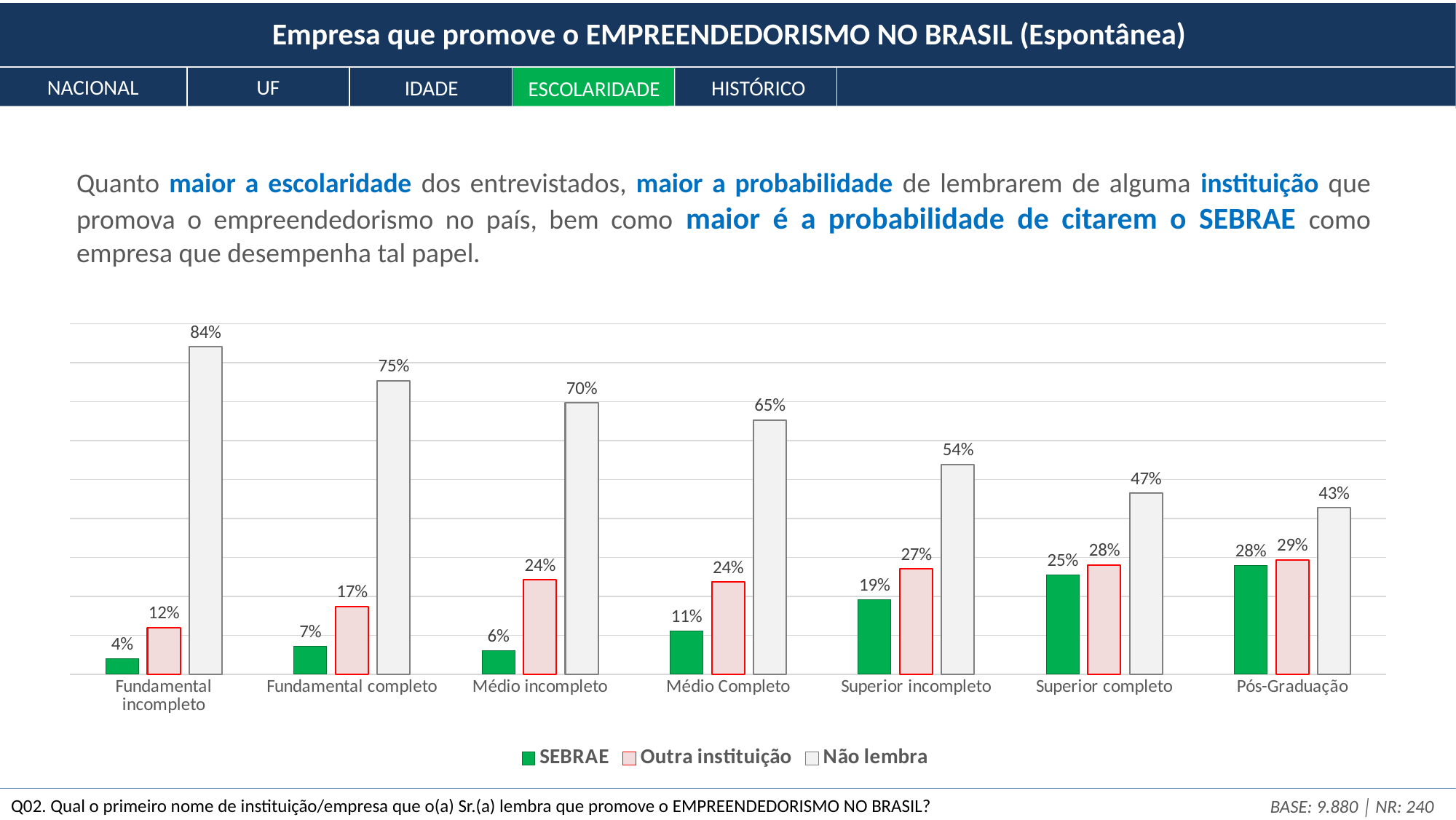
Which education level has the lowest SEBRAE value? Fundamental incompleto What kind of chart is shown on the slide? Bar chart How many education levels are shown on the x axis? 7 Which education level has the highest Não lembra value? Fundamental incompleto Which is larger for Superior incompleto: the SEBRAE value or the Outra instituição value? Outra instituição How many series does the legend list? 3 Which series is shown in green? SEBRAE What is the Outra instituição value for Médio Completo? 24% What is the SEBRAE value for Pós-Graduação? 28% Do the SEBRAE values rise or fall from Fundamental incompleto to Pós-Graduação? Rise What is the Não lembra value for Fundamental incompleto? 84% What is the difference between the Não lembra values for Fundamental incompleto and Pós-Graduação? 41%